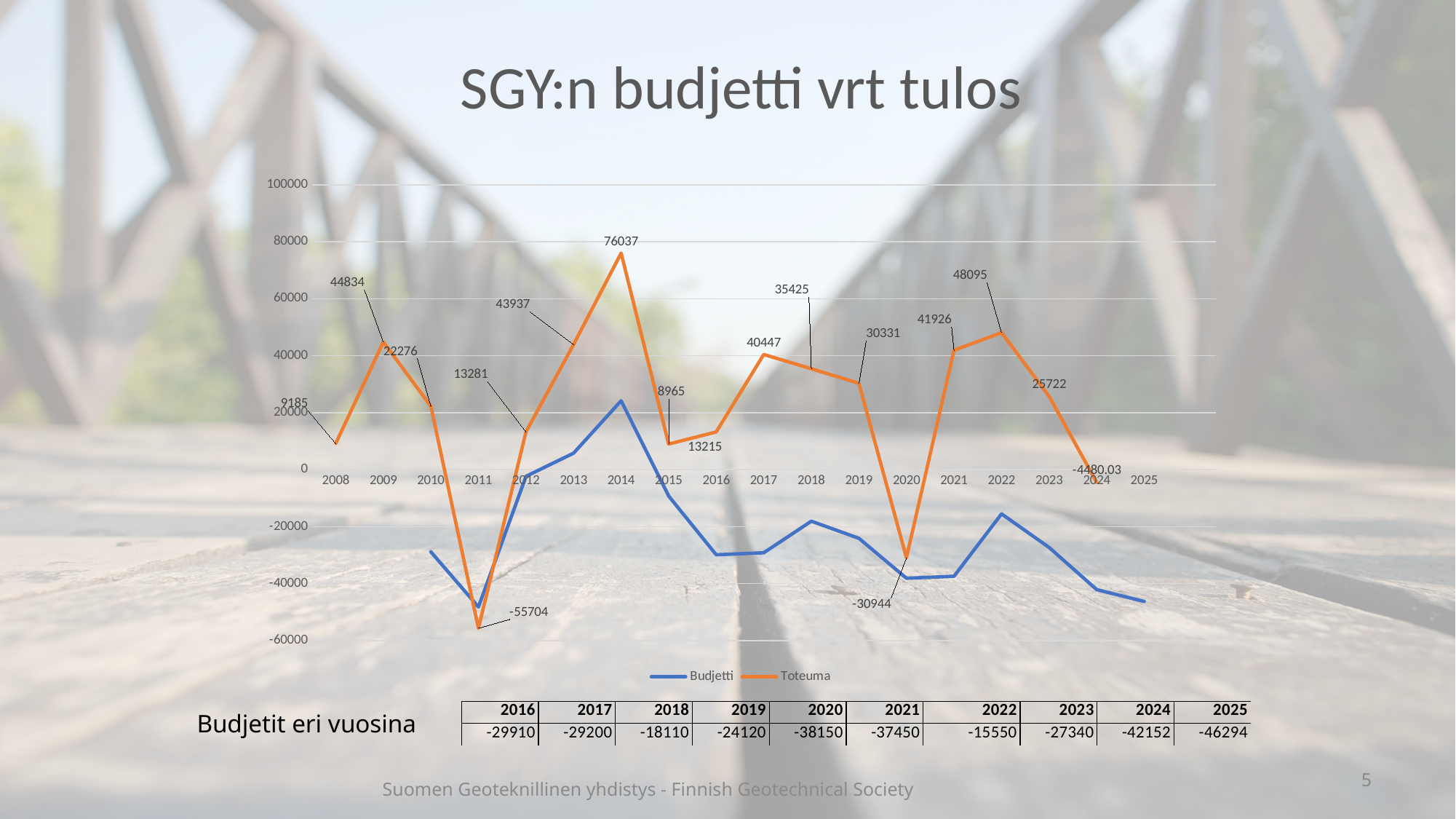
What is the Toteuma value for 2024? -4480.03 How many years are shown on the x axis? 18 In which year is the Toteuma value highest? 2014 What are the two series named in the legend? Budjetti and Toteuma What is the Toteuma value for 2020? -30944 What is the Toteuma value for 2014? 76037 In which year is the Toteuma value lowest? 2011 What is the difference between the Toteuma values for 2022 and 2023? 22373 What kind of chart is shown on the slide? line chart Which is larger, the Toteuma value for 2009 or for 2013? 2009 Is the Budjetti value for 2016 greater or less than -20000? less How many series does the legend list? 2